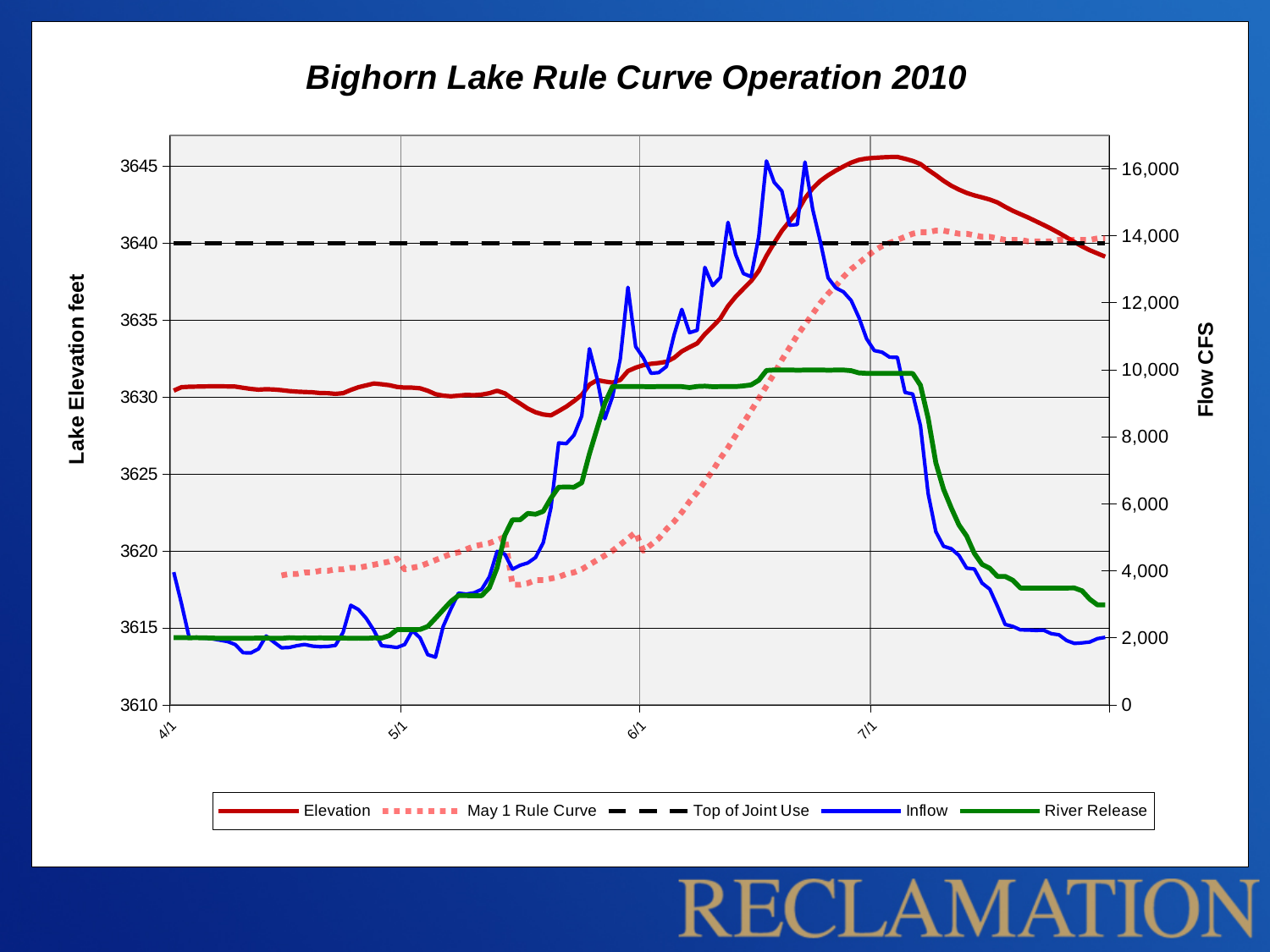
Is the Inflow value on 4/1 greater or less than 6,000? less Does the River Release line rise or fall after 7/1 to the end of the chart? falls What is the title of the chart? Bighorn Lake Rule Curve Operation 2010 How many series does the legend list? 5 What kind of chart is shown on the slide? line chart How many date labels are shown on the x axis? 4 At what lake elevation is the Top of Joint Use line drawn? 3640 What is the label of the left vertical axis? Lake Elevation feet Is the May 1 Rule Curve value on 7/1 greater or less than 3635? greater Is the River Release value on 7/1 greater or less than 8,000? greater Does the Elevation line rise or fall between 6/1 and 7/1? rises